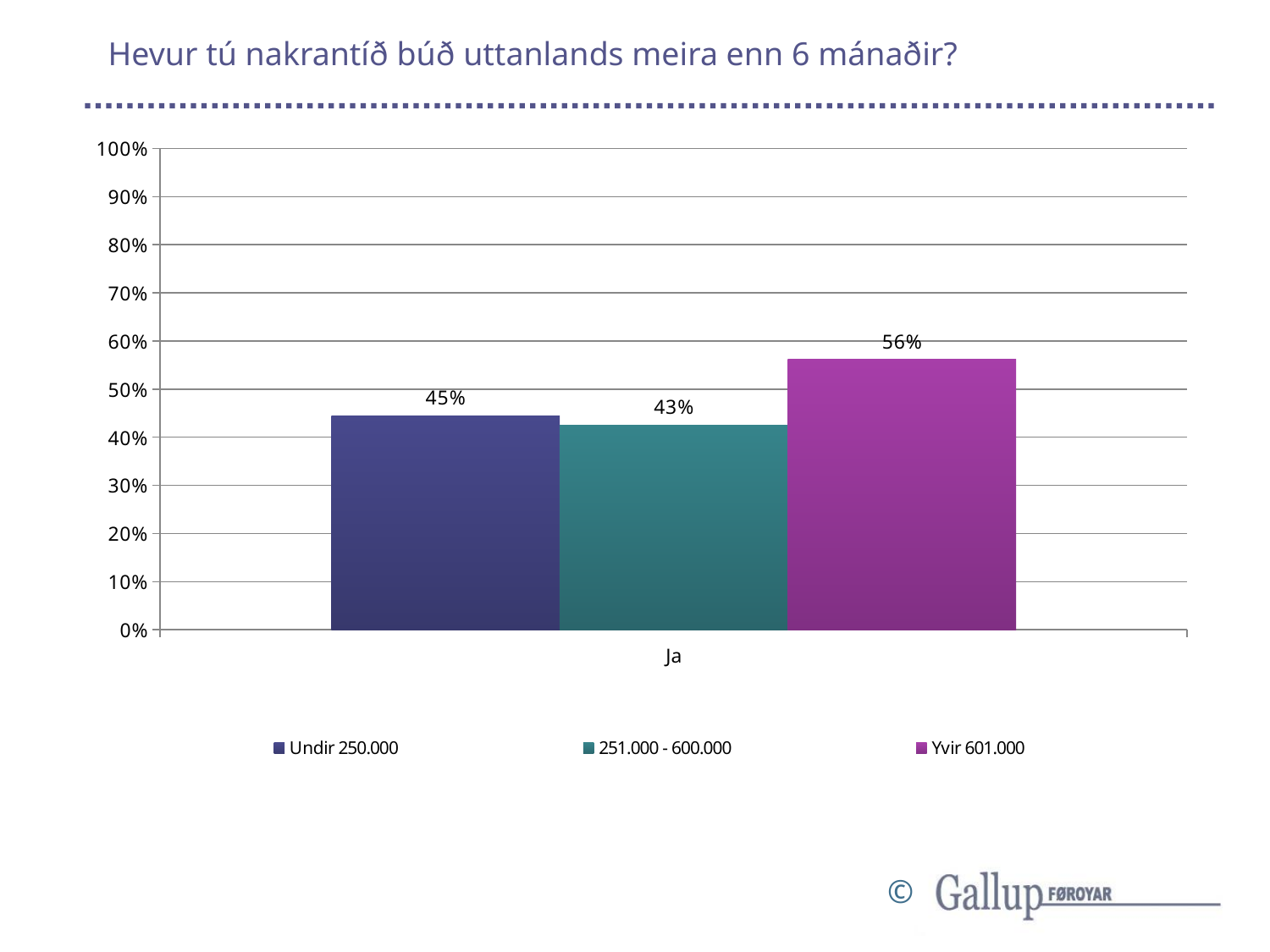
What is the value for the 251.000 - 600.000 series? 43% What is the value for the Yvir 601.000 series? 56% What is the value for the Undir 250.000 series? 45% Is the value for Yvir 601.000 greater or less than 50%? greater What is the category label on the x axis? Ja Which is larger, the value for Yvir 601.000 or the value for 251.000 - 600.000? Yvir 601.000 Which series has the highest value? Yvir 601.000 How many series does the legend list? 3 Which series has the lowest value? 251.000 - 600.000 What kind of chart is shown on the slide? bar chart What is the difference between the Undir 250.000 value and the 251.000 - 600.000 value? 2% What is the difference between the Yvir 601.000 value and the Undir 250.000 value? 11%